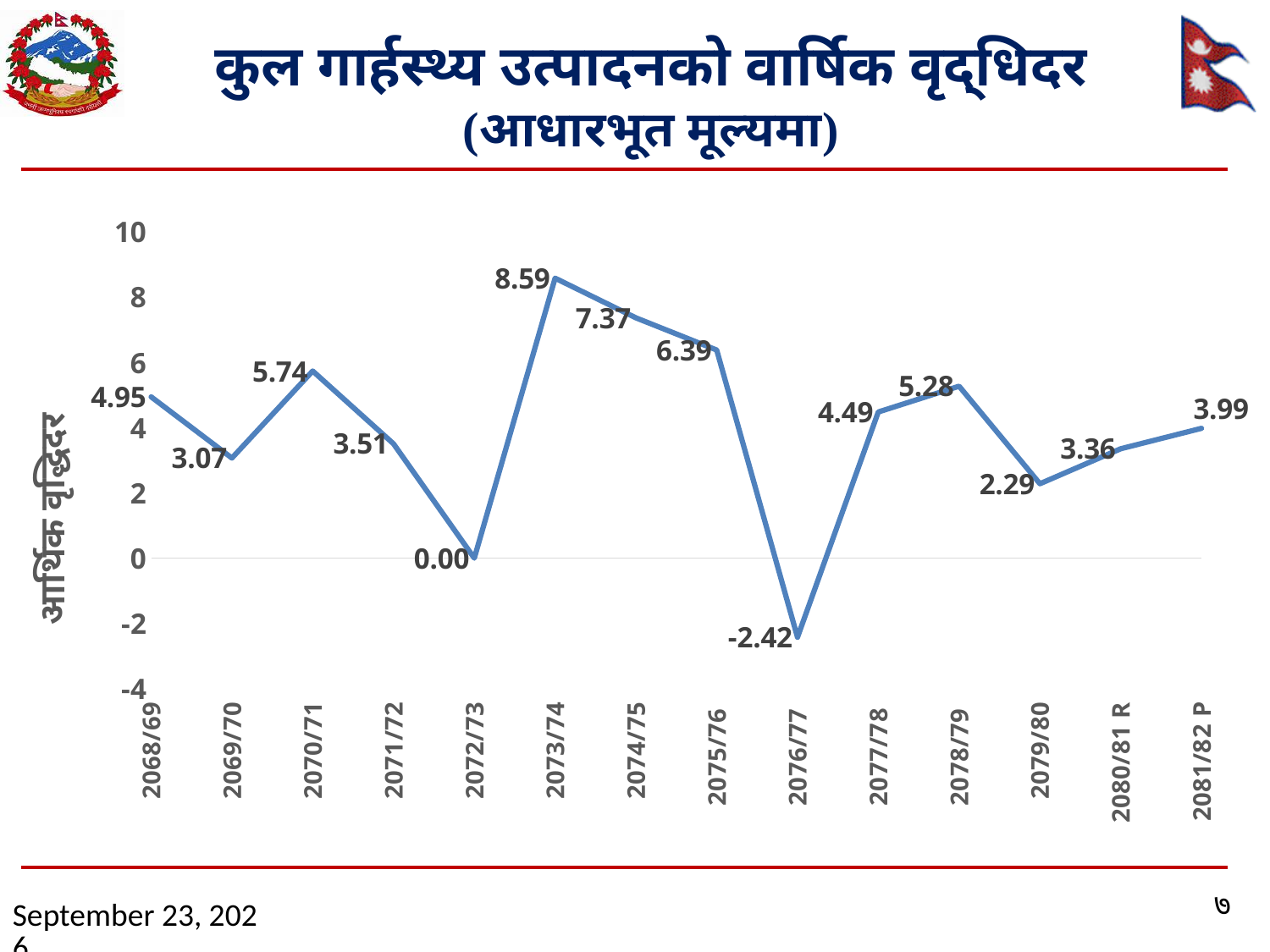
What kind of chart is shown on the slide? line chart Which year has the lowest value? 2076/77 What is the value for 2076/77? -2.42 Which year has the highest value? 2073/74 Is the value for 2075/76 greater or less than 6? greater What is the value for 2073/74? 8.59 Which is larger, the value for 2070/71 or the value for 2078/79? 2070/71 Do the values rise or fall from 2079/80 to 2081/82 P? rise What is the difference between the values for 2073/74 and 2074/75? 1.22 How many years are plotted on the x axis? 14 What is the value for 2072/73? 0.00 What is the value for 2081/82 P? 3.99